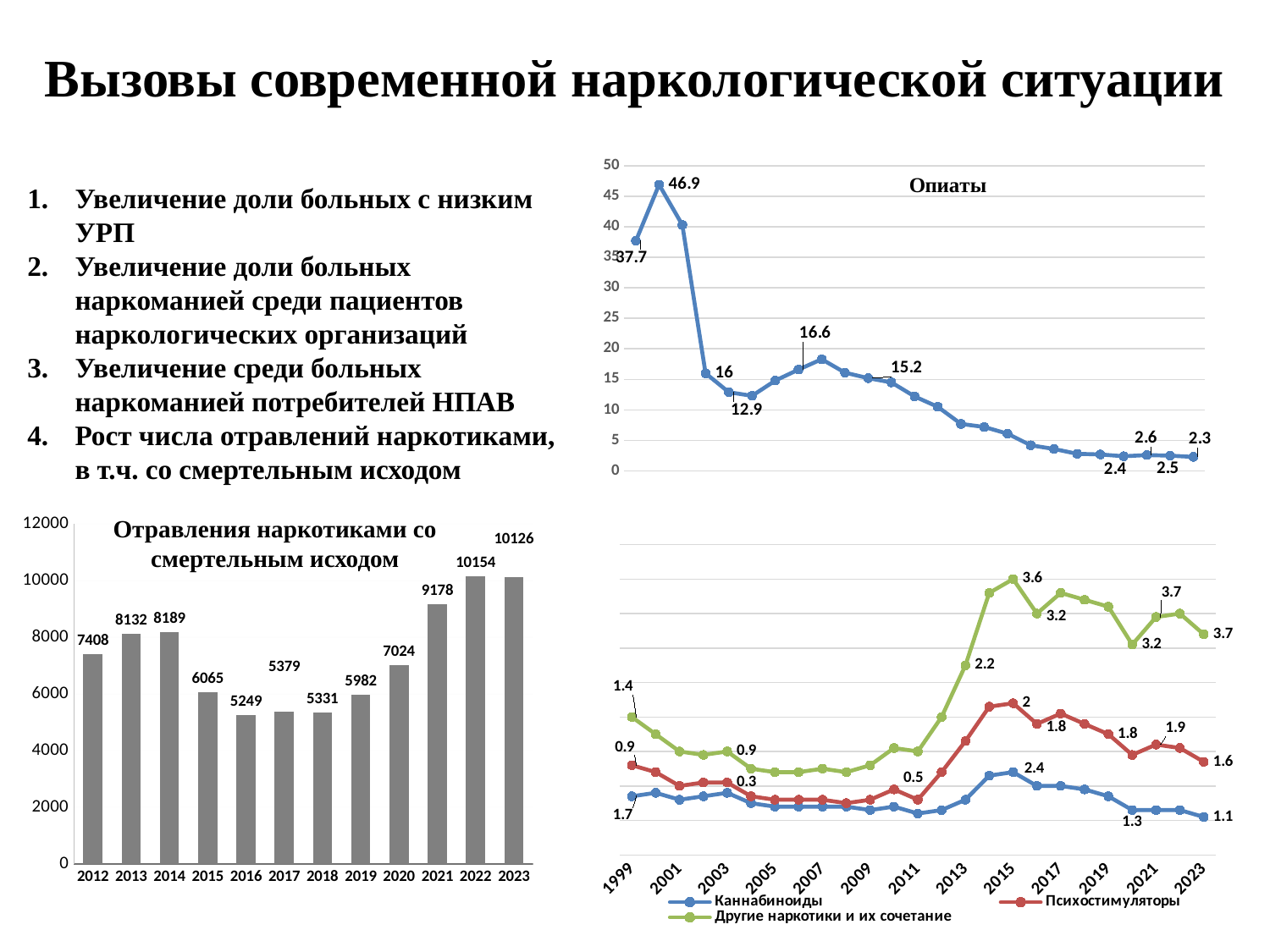
What kind of chart is 'Отравления наркотиками со смертельным исходом'? bar chart In the bar chart 'Отравления наркотиками со смертельным исходом', which year has the highest value? 2022 In the bar chart 'Отравления наркотиками со смертельным исходом', what is the value for 2023? 10126 In the bottom-right line chart, what is the value for Психостимуляторы in 2023? 1.6 How many years are shown in the bar chart 'Отравления наркотиками со смертельным исходом'? 12 In the bar chart 'Отравления наркотиками со смертельным исходом', do the values rise or fall from 2018 to 2022? rise In the 'Опиаты' line chart, what is the highest value shown? 46.9 In the bar chart 'Отравления наркотиками со смертельным исходом', which year has the lowest value? 2016 In the 'Опиаты' line chart, what is the value for 2023? 2.3 How many series does the legend of the bottom-right line chart list? 3 In the bar chart 'Отравления наркотиками со смертельным исходом', which year has the larger value, 2013 or 2014? 2014 In the bar chart 'Отравления наркотиками со смертельным исходом', what is the difference between the values for 2022 and 2021? 976